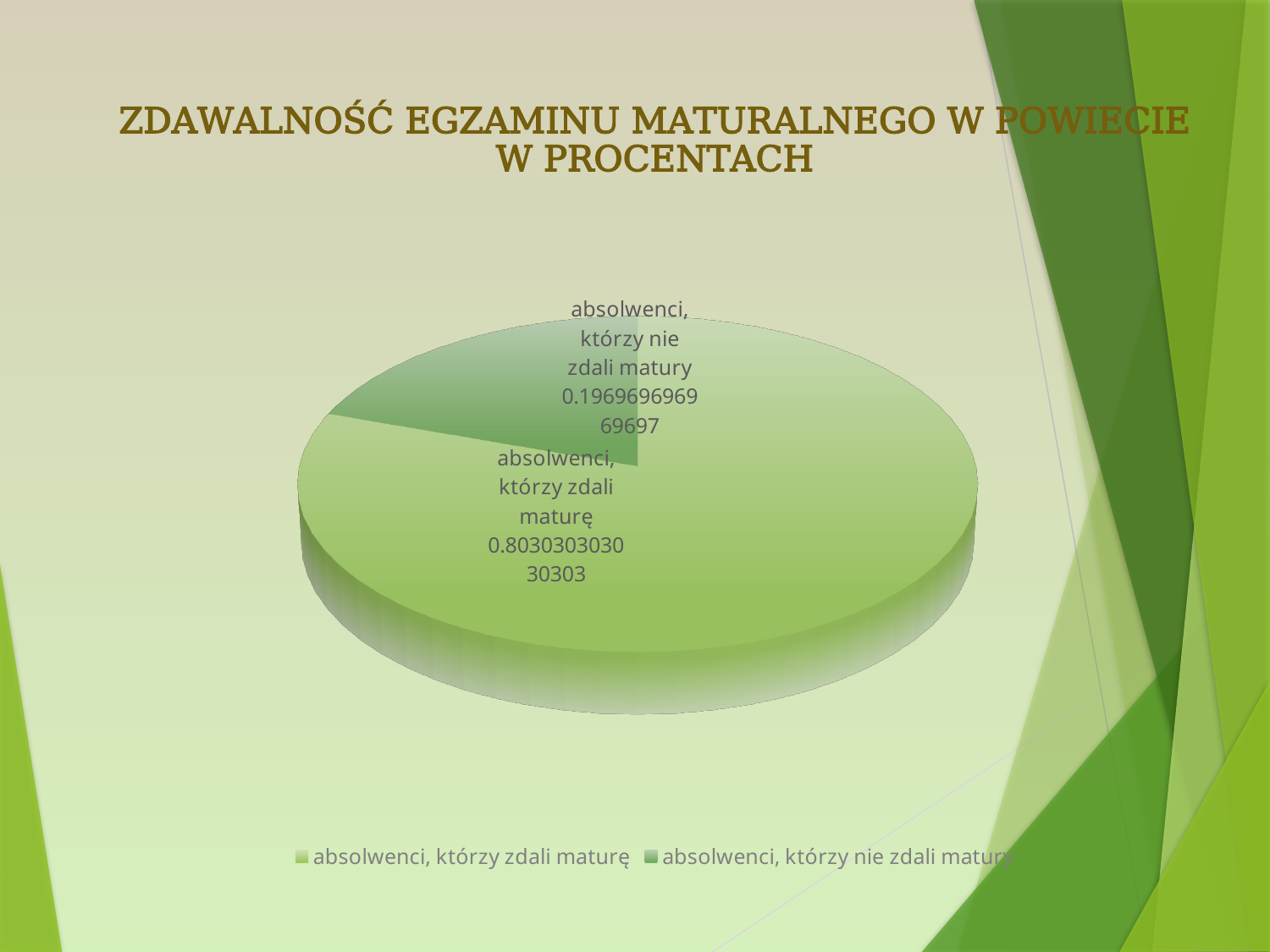
Which legend entry is listed first? absolwenci, którzy zdali maturę Which slice of the pie is the largest? absolwenci, którzy zdali maturę What is the title of the slide containing the chart? ZDAWALNOŚĆ EGZAMINU MATURALNEGO W POWIECIE W PROCENTACH Which slice of the pie is the smallest? absolwenci, którzy nie zdali matury How many slices does the pie chart have? 2 Which is larger: the slice for "absolwenci, którzy zdali maturę" or the slice for "absolwenci, którzy nie zdali matury"? absolwenci, którzy zdali maturę How many entries does the legend list? 2 What is the value shown for "absolwenci, którzy zdali maturę"? 0.803030303030303 What kind of chart is shown on the slide? pie chart What is the value shown for "absolwenci, którzy nie zdali matury"? 0.196969696969697